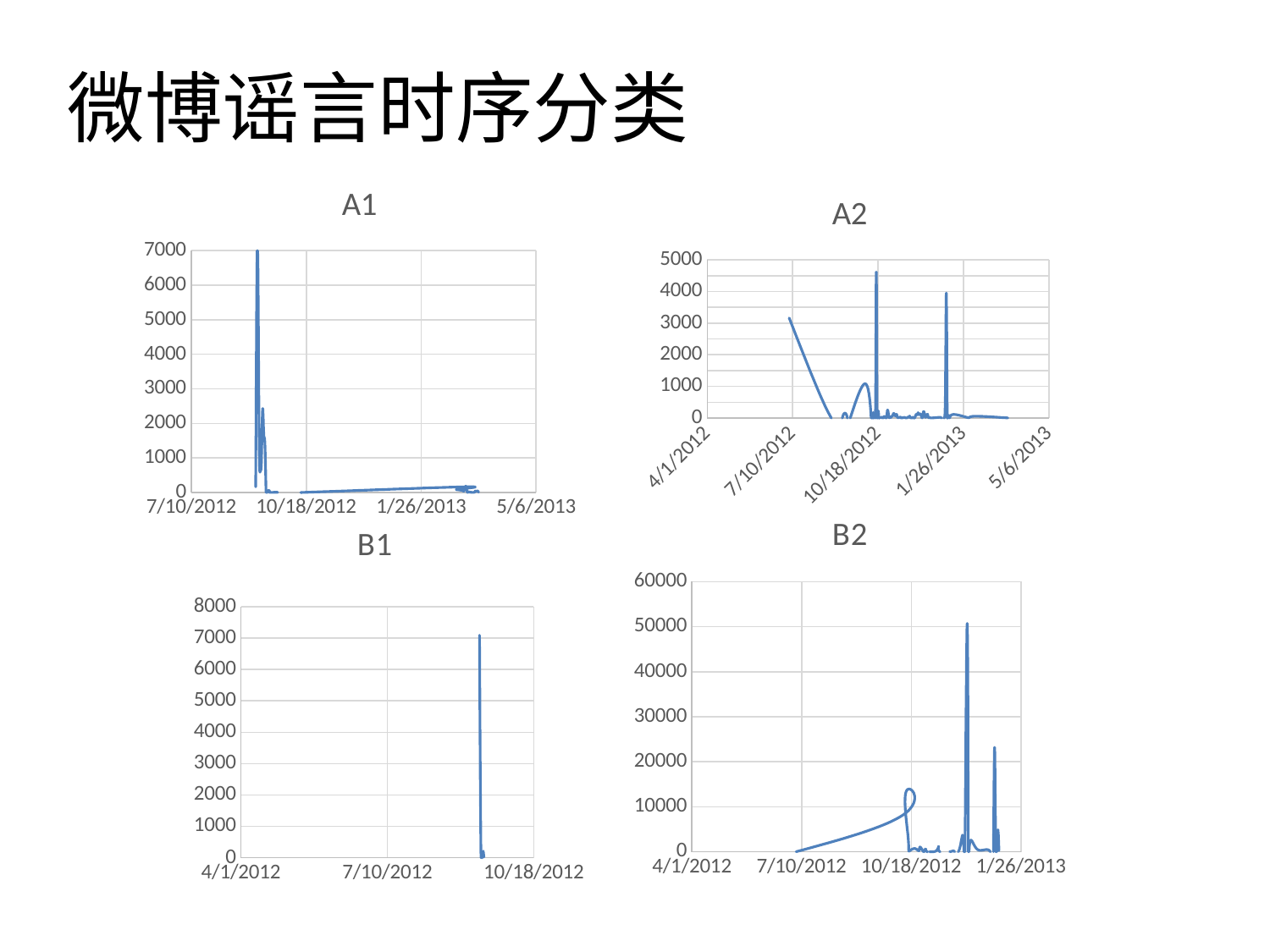
In the chart titled A2, is the highest peak of the line greater or less than 4000? greater What kind of chart is the chart titled A1? line chart In the chart titled A1, is the highest peak of the line greater or less than 6000? greater In the chart titled B2, is the second-highest peak (near 1/26/2013) greater or less than 30000? less In the chart titled A2, does the line rise or fall immediately after its first point near 7/10/2012? fall What are the titles of the four charts on the slide? A1, A2, B1, B2 Which chart reaches a higher peak value, A2 or B2? B2 What is the highest value shown on the y axis of the chart titled B2? 60000 How many charts are shown on the slide? 4